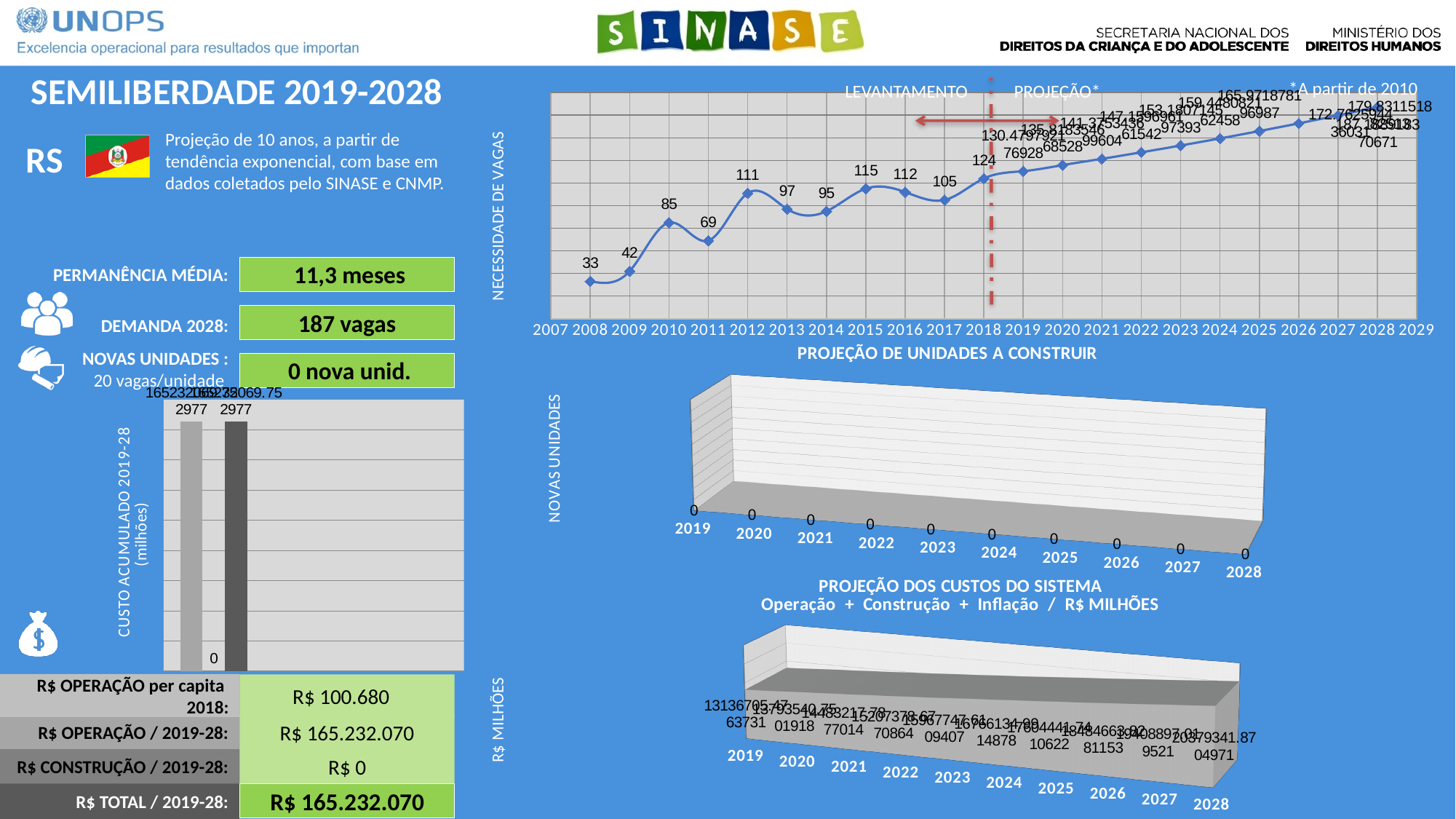
How many years are shown on the x axis of the PROJEÇÃO DE UNIDADES A CONSTRUIR chart? 10 In the NECESSIDADE DE VAGAS line chart, what is the value for 2008? 33 In the NECESSIDADE DE VAGAS line chart, which is larger, the value for 2010 or the value for 2011? 2010 In the PROJEÇÃO DE UNIDADES A CONSTRUIR chart, what is the value for 2024? 0 In the NECESSIDADE DE VAGAS line chart, which year has the highest value? 2028 In the NECESSIDADE DE VAGAS line chart, which year has the lowest value? 2008 What kind of chart is the NECESSIDADE DE VAGAS chart at the top right? line chart In the NECESSIDADE DE VAGAS line chart, what is the value for 2018? 124 In the NECESSIDADE DE VAGAS line chart, do the values rise or fall from 2008 to 2010? rise What is the title of the chart at the bottom right of the slide? PROJEÇÃO DOS CUSTOS DO SISTEMA In the NECESSIDADE DE VAGAS line chart, what is the difference between the values for 2018 and 2008? 91 In the NECESSIDADE DE VAGAS line chart, what is the value for 2012? 111